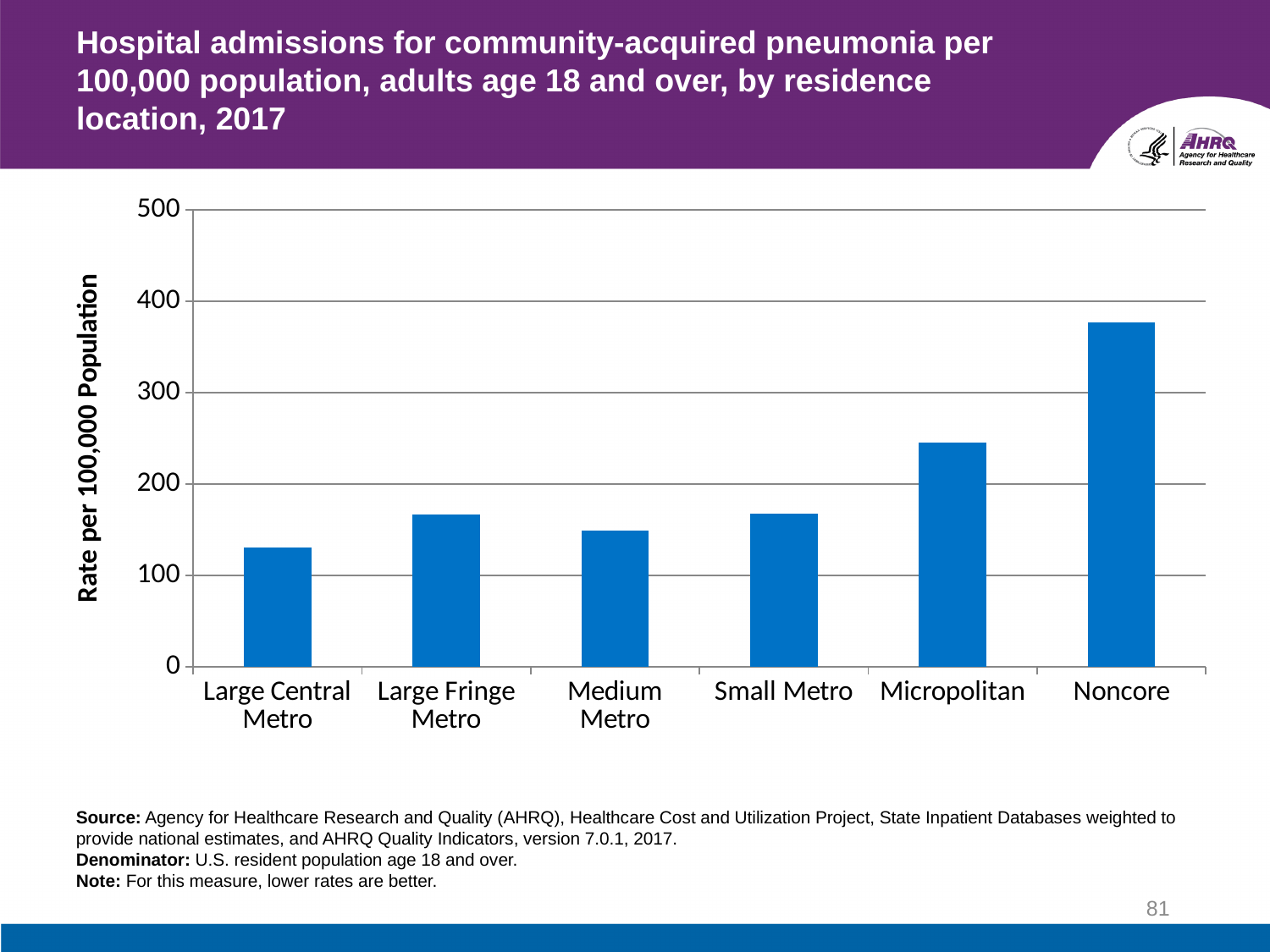
What year does the chart title say the data are from? 2017 Is the value for Noncore greater or less than 300? greater Which residence location has the lowest hospital admission rate? Large Central Metro Is the value for Micropolitan greater or less than 200? greater Which residence location has the highest hospital admission rate? Noncore Is the value for Medium Metro greater or less than 100? greater Which has a higher admission rate, Micropolitan or Small Metro? Micropolitan Which has a lower admission rate, Large Central Metro or Medium Metro? Large Central Metro What is the label on the y axis? Rate per 100,000 Population How many residence location categories are shown on the x axis? 6 What kind of chart is shown on the slide? Bar chart